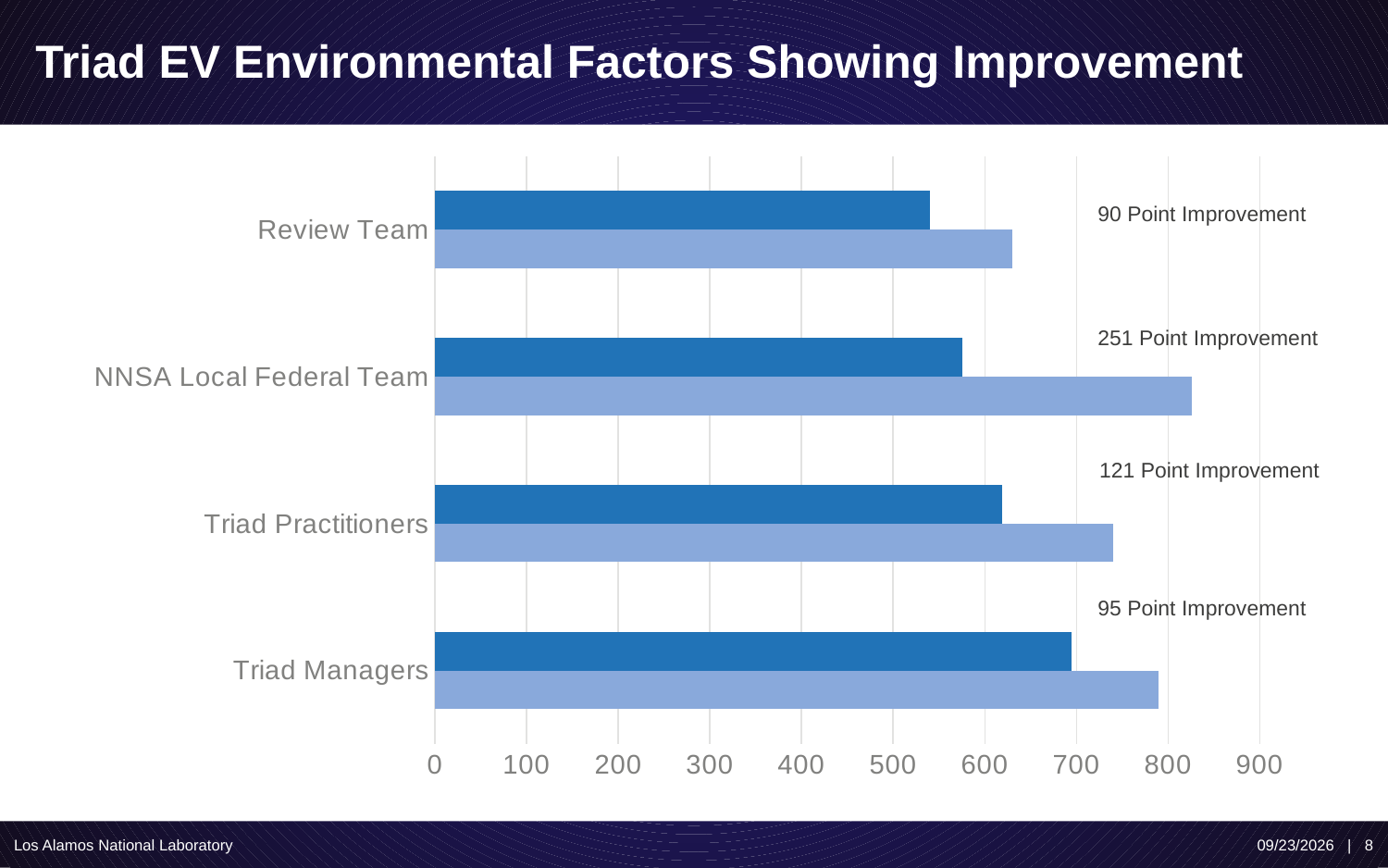
Which category has the longest dark blue bar? Triad Managers What kind of chart is shown on the slide? bar chart Is the light blue bar for NNSA Local Federal Team greater or less than 800? greater What improvement is noted next to the Review Team bars? 90 Point Improvement Is the light blue bar for Triad Practitioners greater or less than 700? greater Which category has the shortest dark blue bar? Review Team For NNSA Local Federal Team, which bar is longer, the dark blue or the light blue? light blue Is the dark blue bar for Review Team greater or less than 600? less How many categories are shown on the chart? 4 Which category has the longest light blue bar? NNSA Local Federal Team What improvement is noted next to the NNSA Local Federal Team bars? 251 Point Improvement Which category has the shortest light blue bar? Review Team